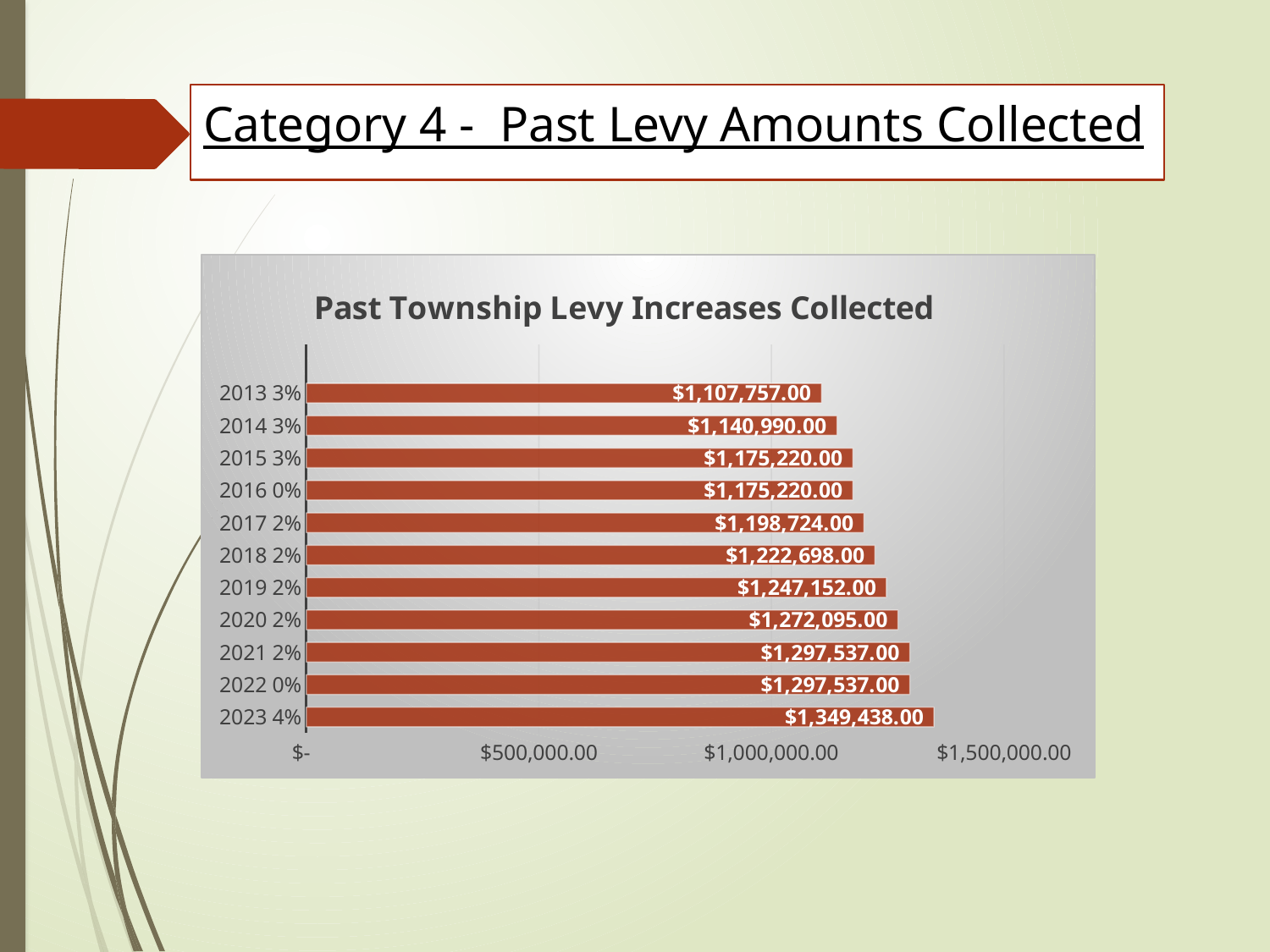
What is the value for 2023 4% in the chart? $1,349,438.00 Which category has the lowest value in the chart? 2013 3% What is the value for 2013 3% in the Past Township Levy Increases Collected chart? $1,107,757.00 What is the difference between the values for 2023 4% and 2022 0%? $51,901.00 Is the value for 2017 2% greater or less than $1,000,000.00? greater Which category has the highest value in the chart? 2023 4% How many bars are shown in the chart? 11 What is the value for 2019 2% in the chart? $1,247,152.00 What is the difference between the values for 2023 4% and 2013 3%? $241,681.00 Which is larger, the value for 2018 2% or the value for 2020 2%? 2020 2% What is the title of the chart? Past Township Levy Increases Collected What kind of chart is shown on the slide? Bar chart